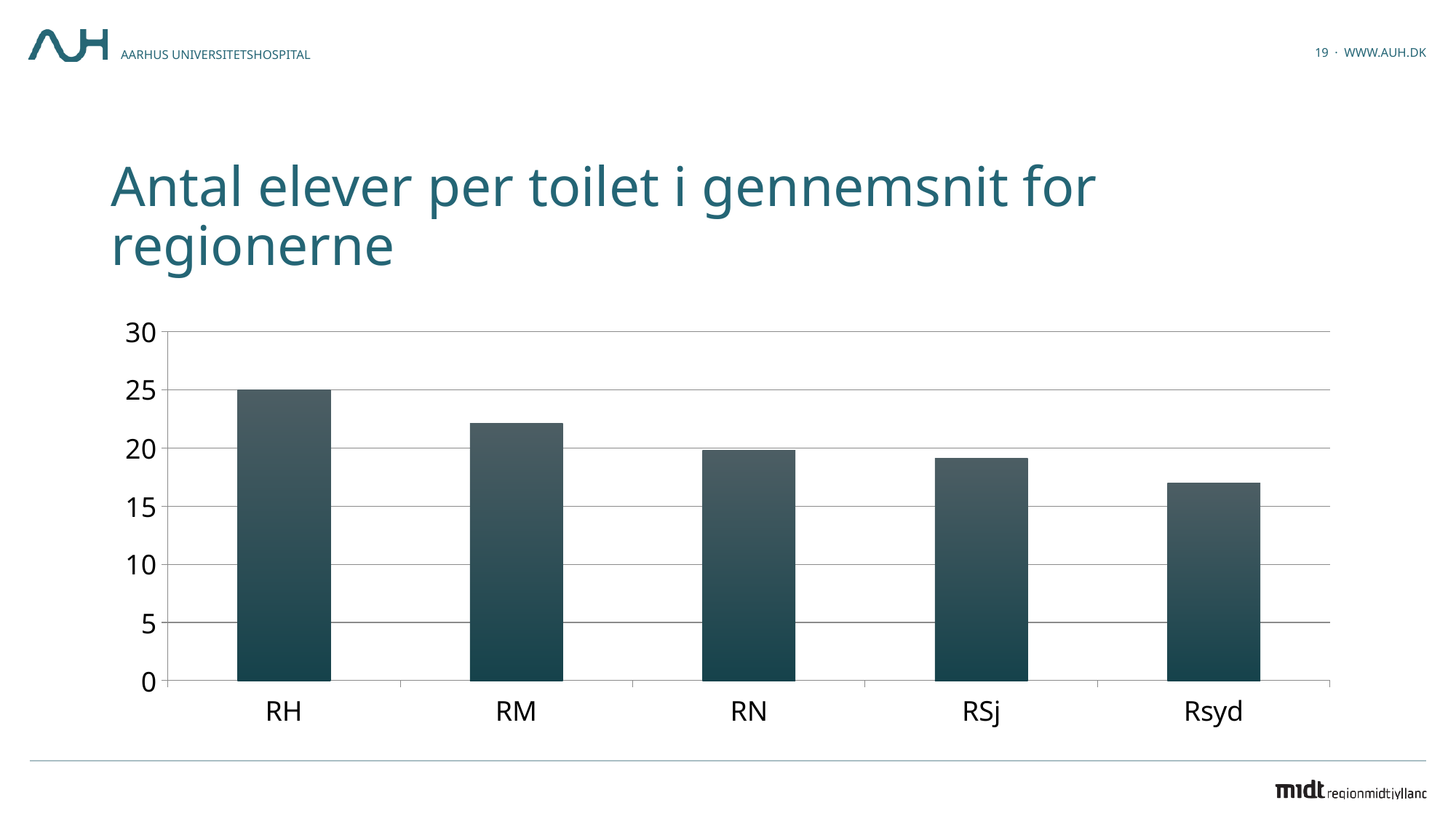
Which region has the lowest average number of pupils per toilet? Rsyd Do the values rise or fall from left to right along the x axis? fall What is the title of the slide containing the chart? Antal elever per toilet i gennemsnit for regionerne What kind of chart is shown on the slide? bar chart Is the value for RSj greater or less than 20? less Is the value for Rsyd greater or less than 15? greater Which is larger, the value for RM or the value for RSj? RM Is the value for Rsyd greater or less than 20? less How many regions (categories) are shown on the x axis of the chart? 5 Which region has the highest average number of pupils per toilet? RH